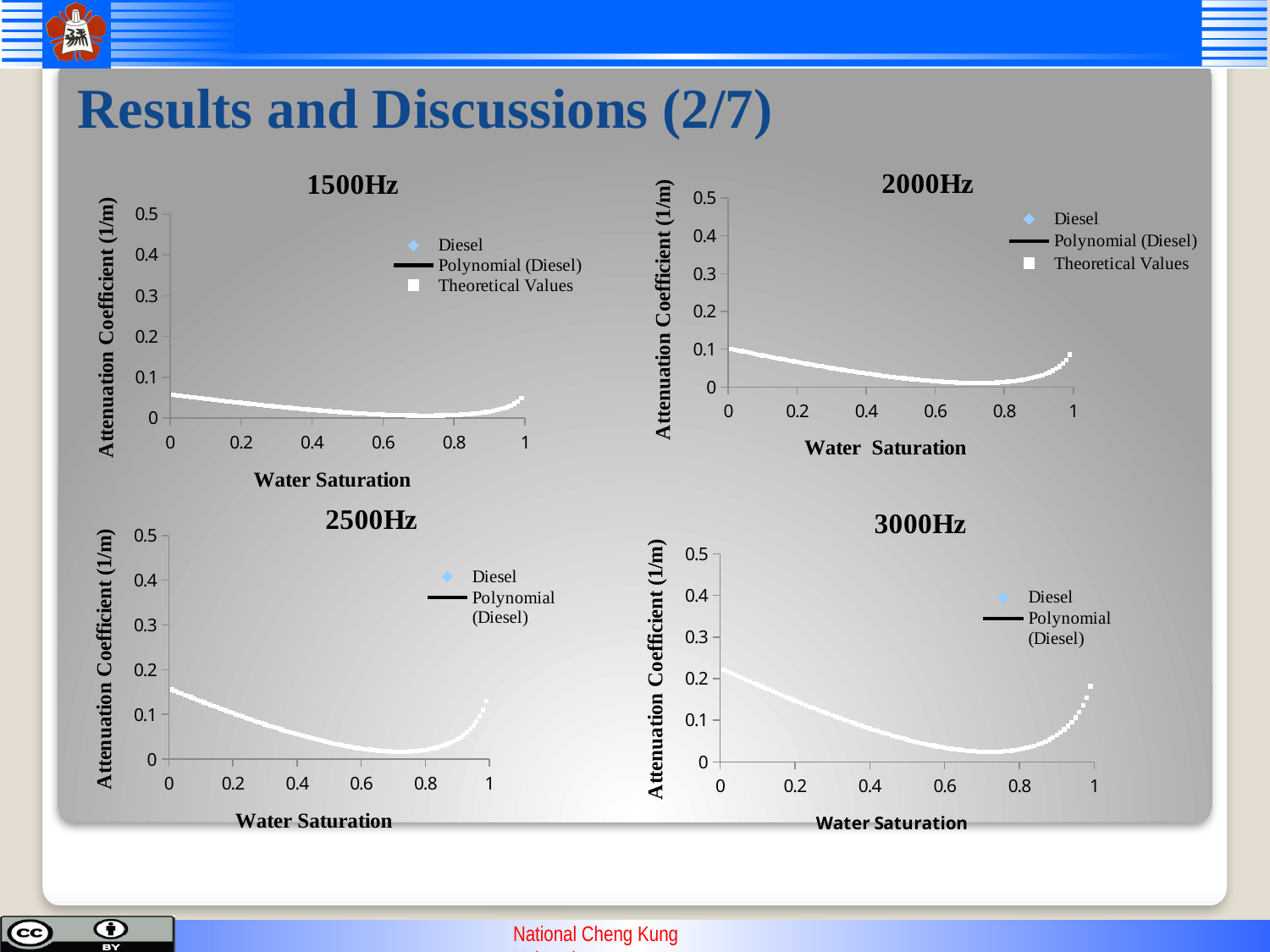
What kind of chart is the 2000Hz chart? Scatter chart What is the y-axis title of the 2000Hz chart? Attenuation Coefficient (1/m) In the 2500Hz chart, how many series does the legend list? 2 In the 2500Hz chart, is the attenuation coefficient at water saturation 0 larger or smaller than at water saturation 0.6? larger How many charts are shown on the slide? 4 In the 3000Hz chart, is the attenuation coefficient at water saturation 0 greater or less than 0.2? greater In the 3000Hz chart, do the values rise or fall as water saturation increases from 0 to 0.6? fall In the 2500Hz chart, is the attenuation coefficient at water saturation 0 greater or less than 0.1? greater In the 1500Hz chart, is the attenuation coefficient at water saturation 0 greater or less than 0.1? less What is the x-axis title of the 1500Hz chart? Water Saturation In the 3000Hz chart, how many series does the legend list? 2 In the 1500Hz chart, how many series does the legend list? 3